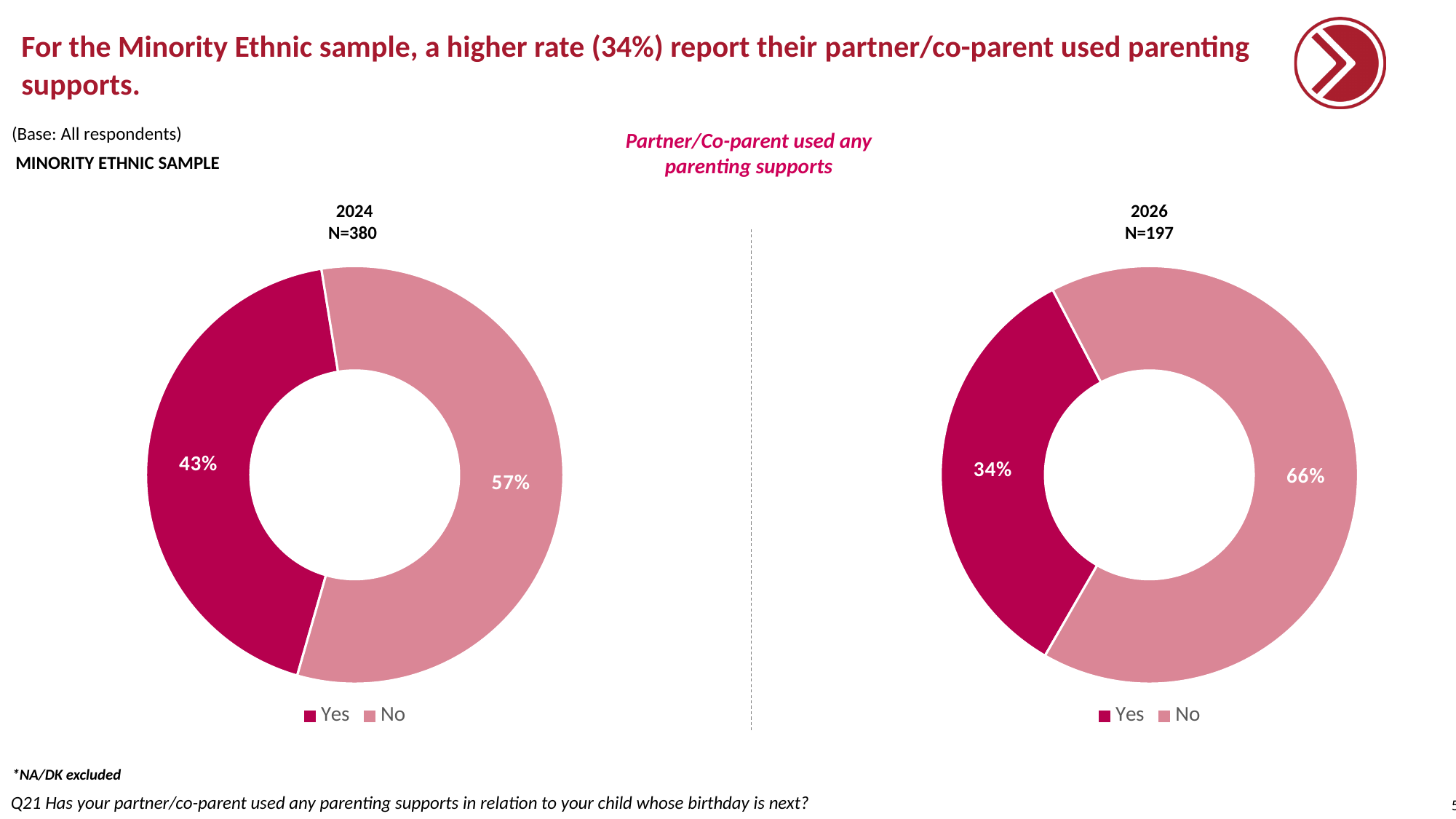
In the 2024 chart, what percentage answered Yes? 43% In the 2024 chart, what percentage answered No? 57% In the 2024 chart, what is the difference between the No and Yes percentages? 14% What is the sample size (N) shown for the 2026 chart? N=197 In the 2024 chart, which category has the smallest share? Yes What type of chart is used on this slide? Doughnut chart How many categories does the legend of the 2026 chart list? 2 What is the sample size (N) shown for the 2024 chart? N=380 In the 2026 chart, which category has the largest share? No Is the Yes share larger in the 2024 chart or the 2026 chart? 2024 In the 2026 chart, what percentage answered No? 66% In the 2026 chart, what percentage answered Yes? 34%